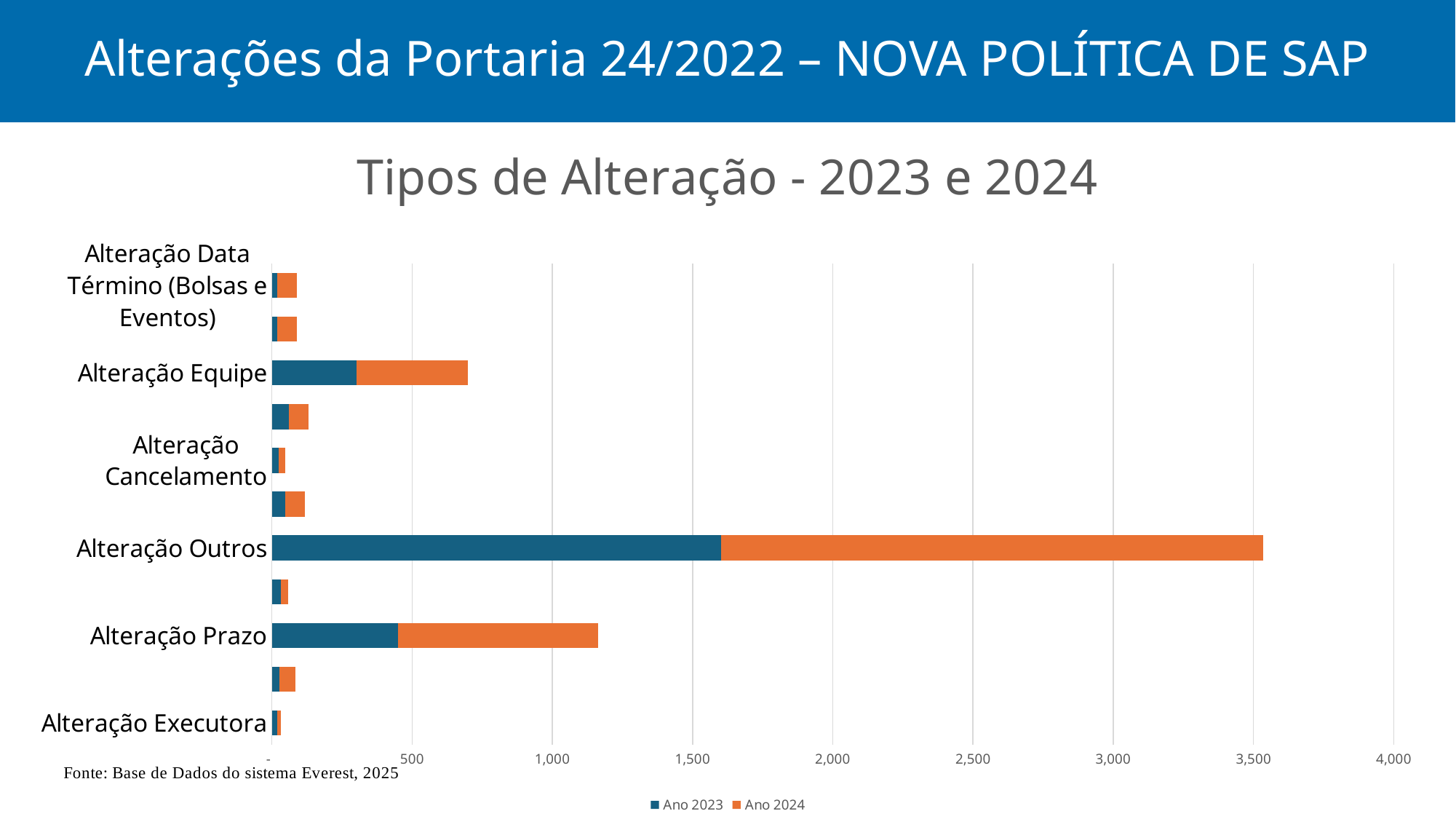
Among the labeled categories, which has the shortest total bar? Alteração Executora Is the total value for Alteração Prazo greater or less than 1,000? greater What is the title of the chart? Tipos de Alteração - 2023 e 2024 What kind of chart is shown on the slide? Bar chart Which has the larger total bar, Alteração Prazo or Alteração Equipe? Alteração Prazo Is the total value for Alteração Executora greater or less than 500? less How many series does the legend list? 2 For Alteração Prazo, which series has the longer segment, Ano 2023 or Ano 2024? Ano 2024 Which category has the longest total bar? Alteração Outros Is the total value for Alteração Outros greater or less than 3,000? greater What are the two series named in the legend? Ano 2023 and Ano 2024